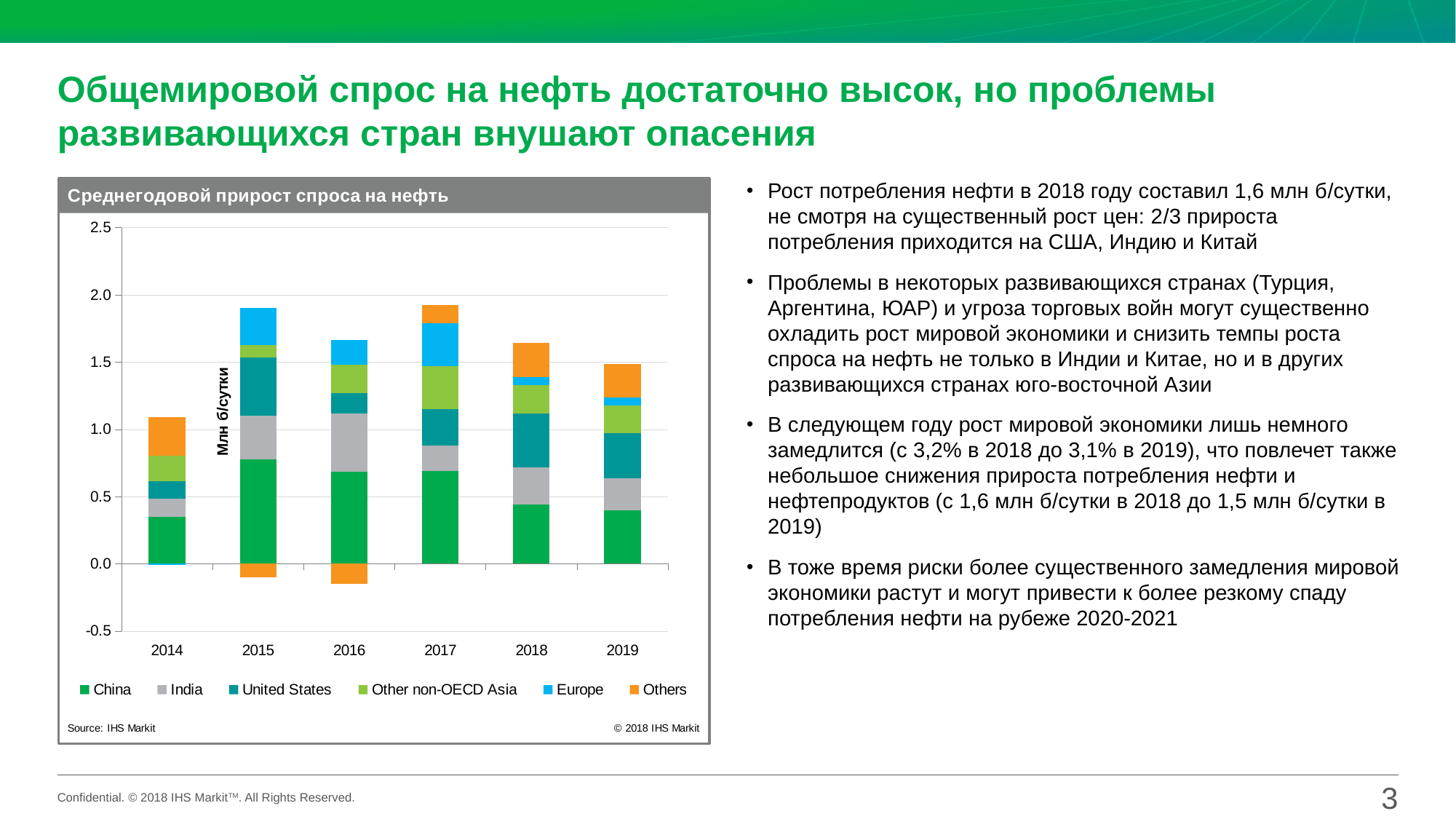
Is the China segment for 2015 greater or less than 0.5? greater Is the China segment for 2014 greater or less than 0.5? less Is the top of the stacked bar for 2017 greater or less than 2.0? less What kind of chart is shown on the slide? Stacked bar chart How many years are shown on the x axis of the chart? 6 What is the title of the chart? Среднегодовой прирост спроса на нефть How many series does the chart legend list? 6 Which is larger, the China segment in 2015 or the China segment in 2019? 2015 What is the y-axis label of the chart? Млн б/сутки Which year has the lowest total positive stacked bar height? 2014